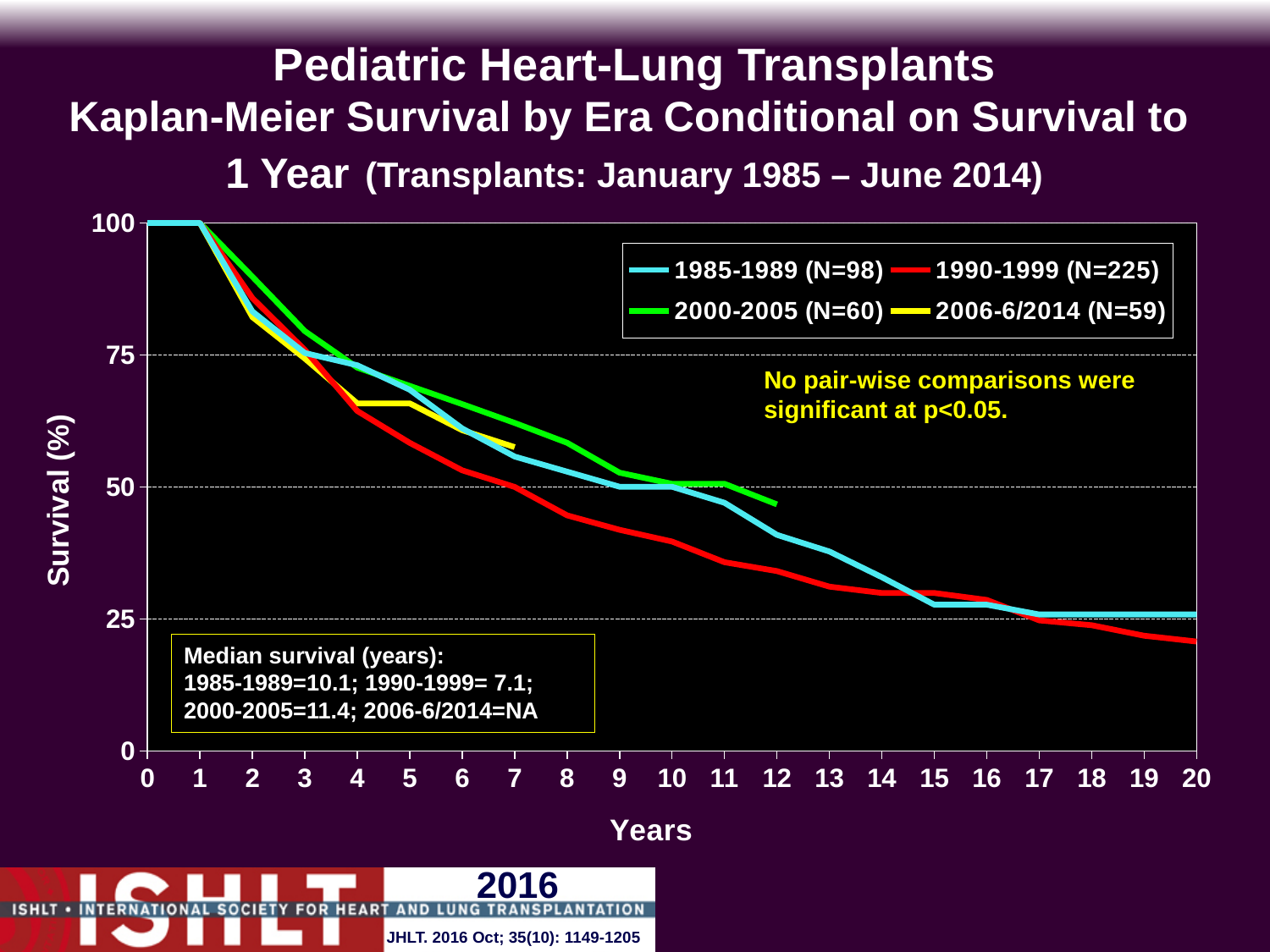
What is the median survival in years for the 2000-2005 era? 11.4 What is the label on the x axis? Years What is the difference in median survival (years) between the 1985-1989 era and the 1990-1999 era? 3.0 How many series does the legend list? 4 What kind of chart is shown on the slide? line chart According to the legend, what is N for the 1990-1999 era? 225 Is the survival for the 2000-2005 era at year 5 greater or less than 50? greater At year 8, which era has higher survival, 2000-2005 or 1990-1999? 2000-2005 Is the survival for the 1990-1999 era at year 10 greater or less than 50? less What colour is the line for the 2000-2005 era? green What is the median survival given for the 2006-6/2014 era? NA Of the three eras with a numeric median survival printed, which has the highest median survival? 2000-2005